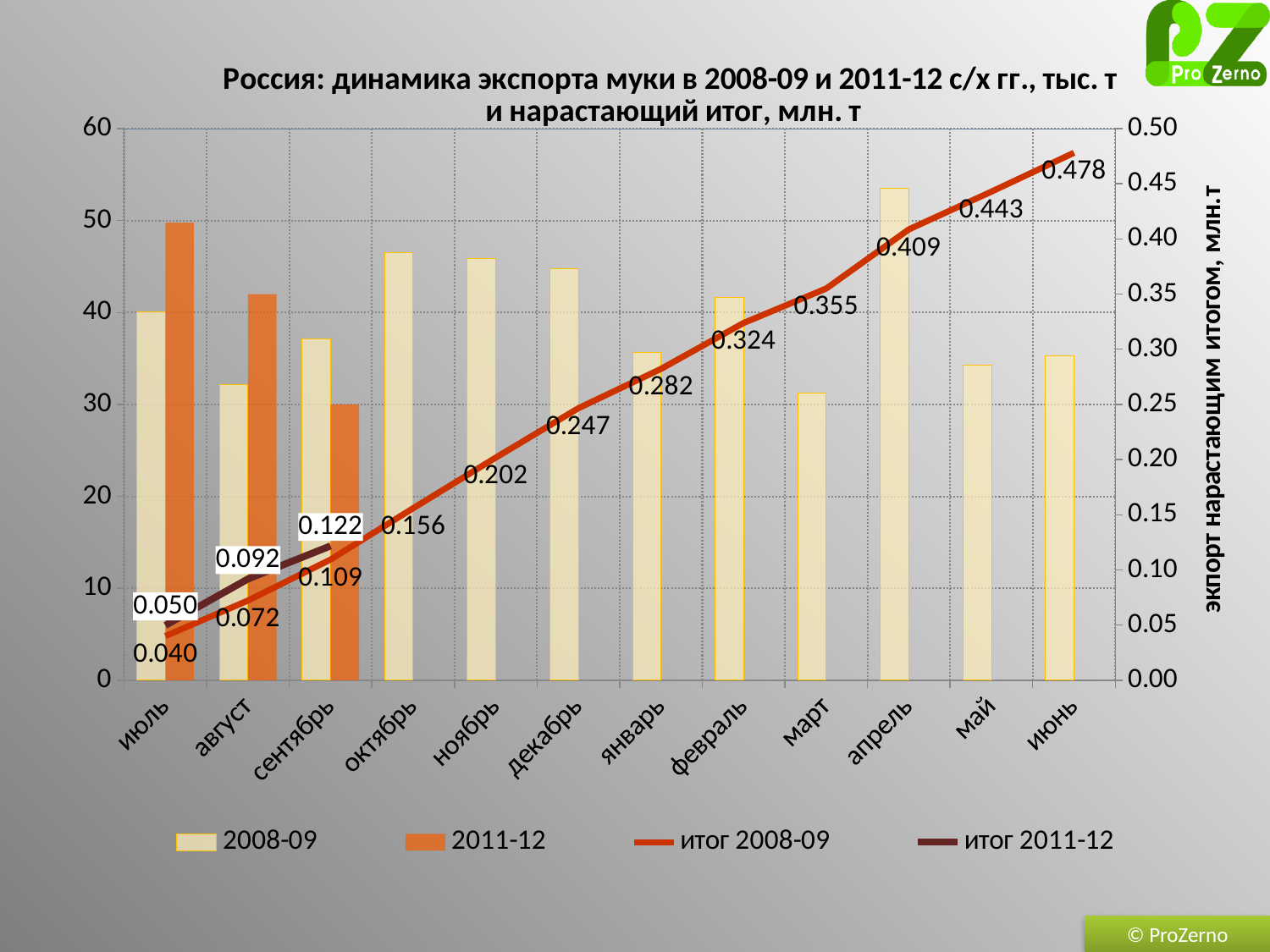
What is the value of the итог 2008-09 line in декабрь? 0.247 In which month is the 2008-09 bar the highest? апрель Does the итог 2008-09 line rise or fall from июль to июнь? rises What is the value of the итог 2011-12 line in сентябрь? 0.122 In июль, which line has the larger value: итог 2008-09 or итог 2011-12? итог 2011-12 In июль, which bar is taller: 2008-09 or 2011-12? 2011-12 How many months are shown on the x axis? 12 Is the 2008-09 bar for апрель greater or less than 50? greater What is the value of the итог 2008-09 line in июнь? 0.478 In август, how much higher is the итог 2011-12 value than the итог 2008-09 value? 0.020 Is the 2011-12 bar for сентябрь greater or less than 40? less How many series does the legend list? 4